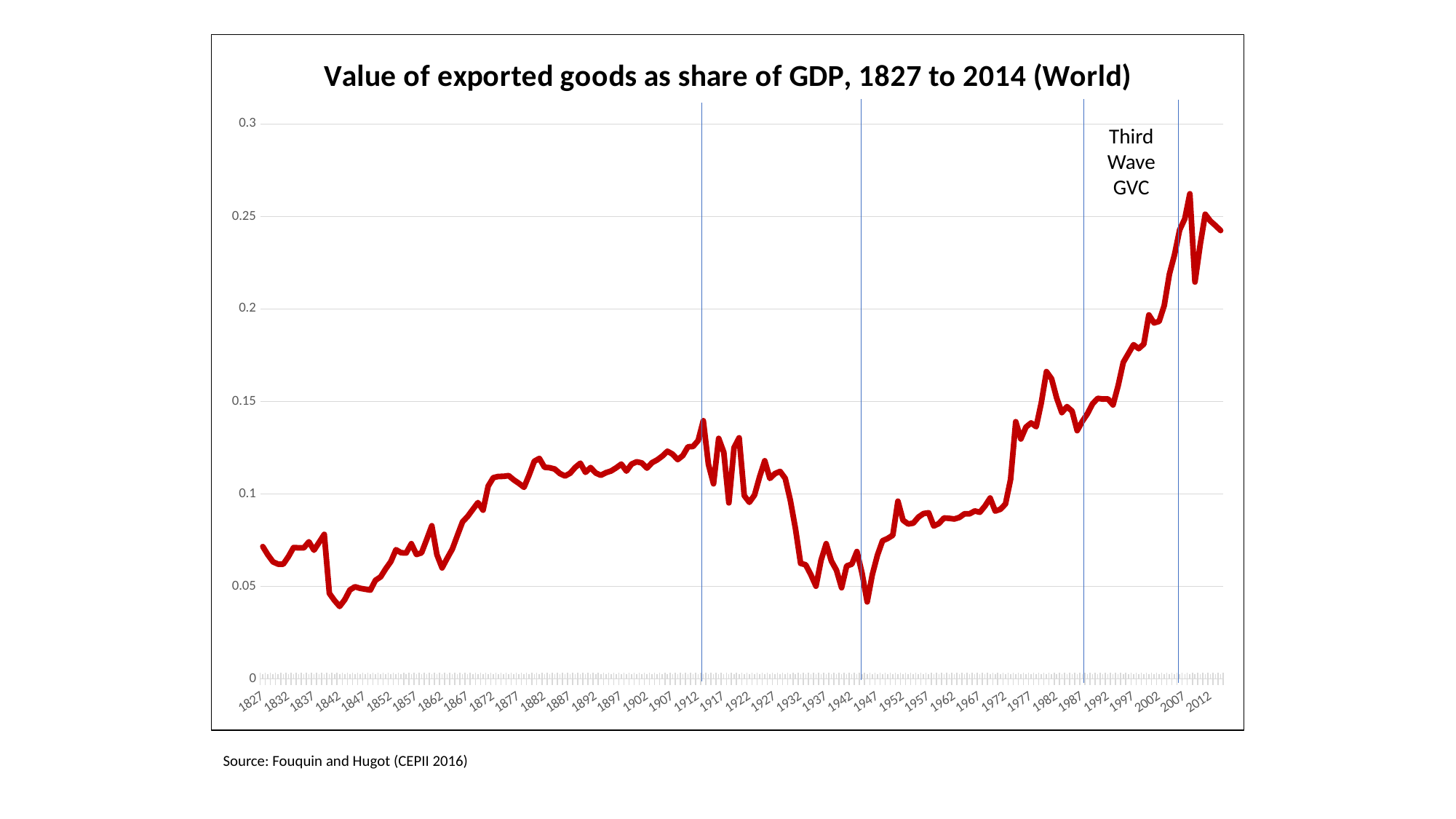
Is the value for 1912 greater or less than 0.1? greater Is the value for 1842 greater or less than 0.05? less What annotation text appears near the right side of the chart between the vertical reference lines? Third Wave GVC Is the value for 1827 greater or less than 0.05? greater What is the title of the chart? Value of exported goods as share of GDP, 1827 to 2014 (World) Which year has the larger value, 1912 or 1947? 1912 Does the value generally rise or fall between 1947 and 2007? Rise Does the value generally rise or fall between 1912 and 1947? Fall What kind of chart is shown on the slide? Line chart